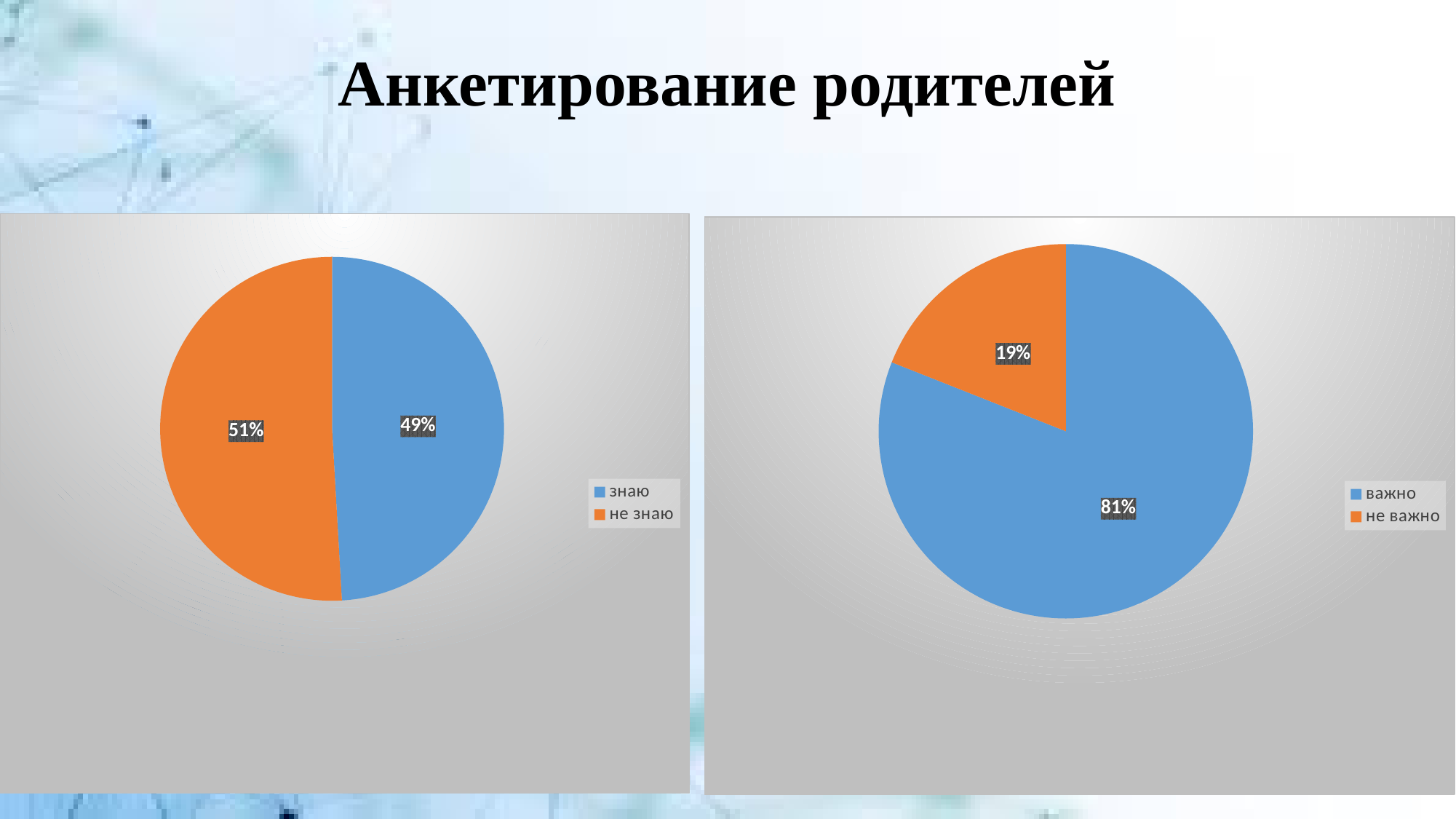
In the right pie chart, which slice is the largest? важно In the right pie chart, what share is labelled for "не важно"? 19% What type of chart is shown on the right side of the slide? pie chart How many slices does the left pie chart have? 2 In the left pie chart, what is the difference between the "не знаю" and "знаю" shares? 2% In the right pie chart, is the share for "важно" greater or less than 50%? greater In the right pie chart, which slice is the smallest? не важно What is the title of the slide? Анкетирование родителей In the right pie chart, what share is labelled for "важно"? 81% In the left pie chart, what share is labelled for "знаю"? 49% In the right pie chart, what is the difference between the "важно" and "не важно" shares? 62%